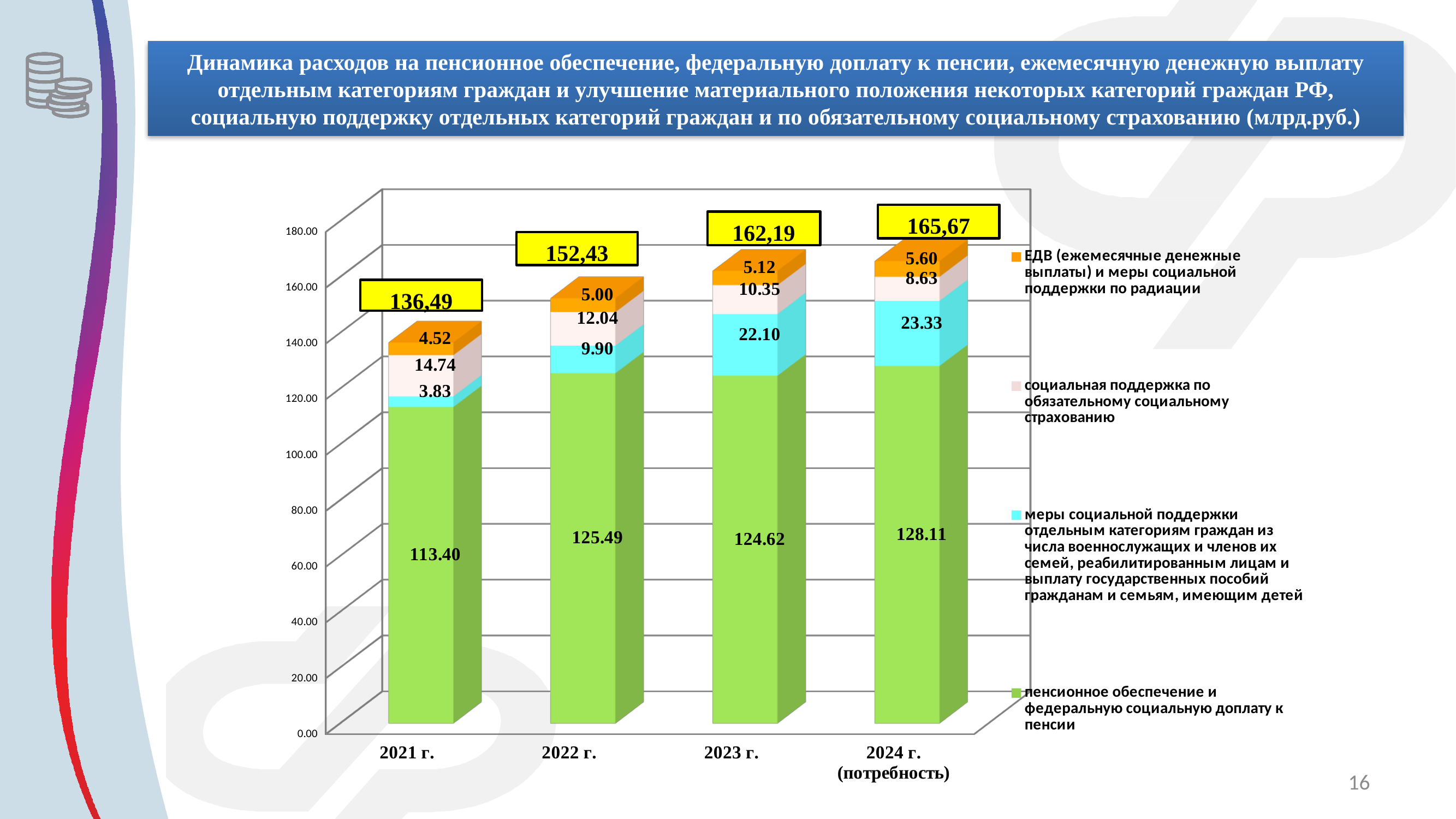
Which year has the lowest total? 2021 г. What is the value for пенсионное обеспечение и федеральную социальную доплату к пенсии in 2021 г.? 113.40 How many years (categories) are shown on the x axis? 4 Which is larger: the меры социальной поддержки value in 2023 г. or in 2022 г.? 2023 г. Do the bar totals rise or fall from 2021 г. to 2024 г. (потребность)? rise What type of chart is shown on the slide? stacked bar chart Which year has the highest total? 2024 г. (потребность) How many series does the legend list? 4 What is the value for ЕДВ (ежемесячные денежные выплаты) и меры социальной поддержки по радиации in 2023 г.? 5.12 What is the difference between the пенсионное обеспечение values for 2024 г. (потребность) and 2021 г.? 14.71 What is the total shown above the bar for 2024 г. (потребность)? 165,67 What is the value for социальная поддержка по обязательному социальному страхованию in 2022 г.? 12.04